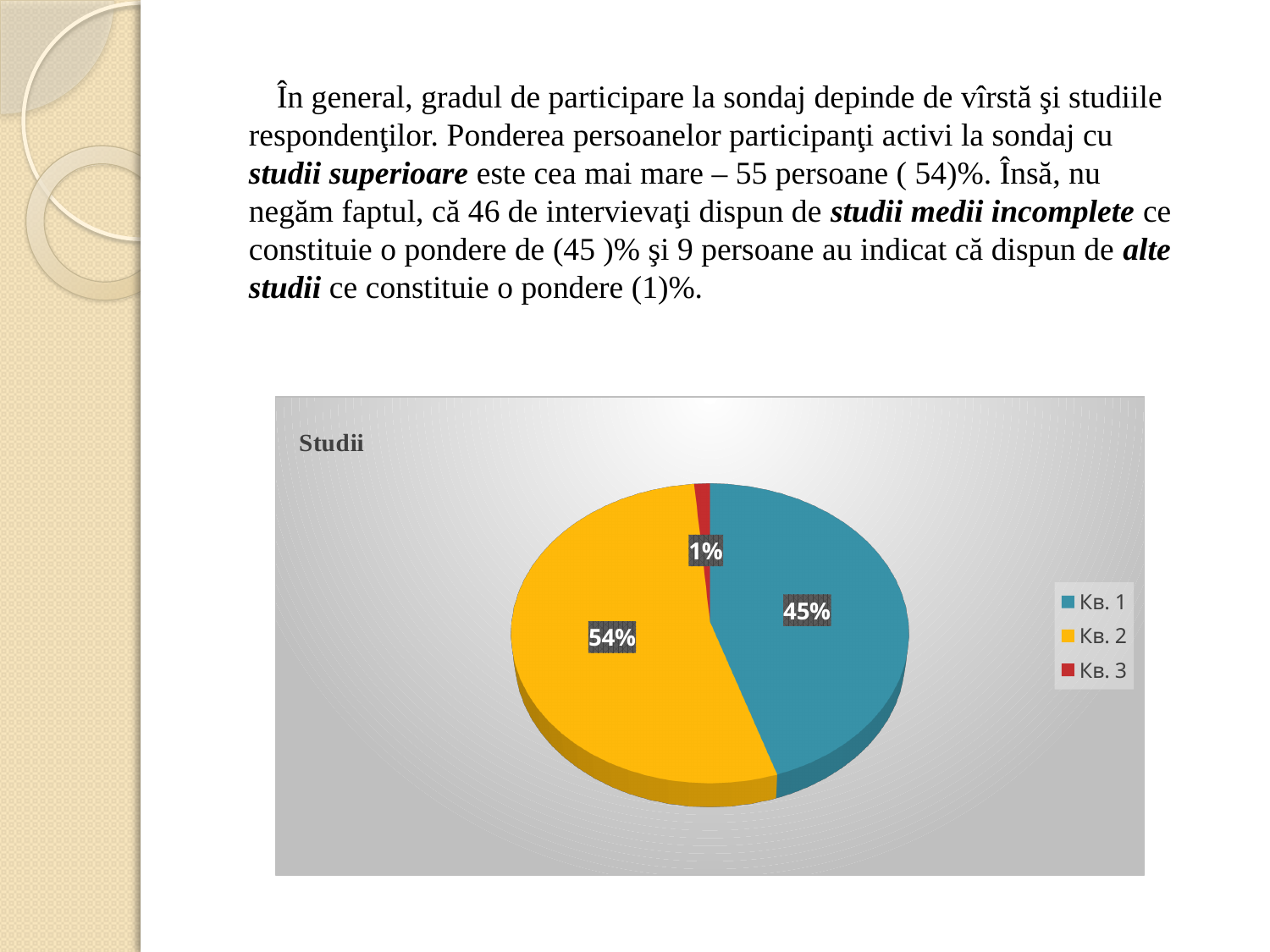
What is the difference in percentage points between the Кв. 2 slice and the Кв. 1 slice? 9 What percentage does the slice for Кв. 2 show? 54% How many entries does the legend list? 3 What percentage does the slice for Кв. 1 show? 45% Which category has the largest slice of the pie? Кв. 2 What is the title of the chart? Studii What percentage does the slice for Кв. 3 show? 1% Which slice is larger, Кв. 1 or Кв. 3? Кв. 1 What kind of chart is shown on the slide? pie chart What colour is the slice for Кв. 2? yellow How many slices does the pie chart have? 3 Which category has the smallest slice of the pie? Кв. 3